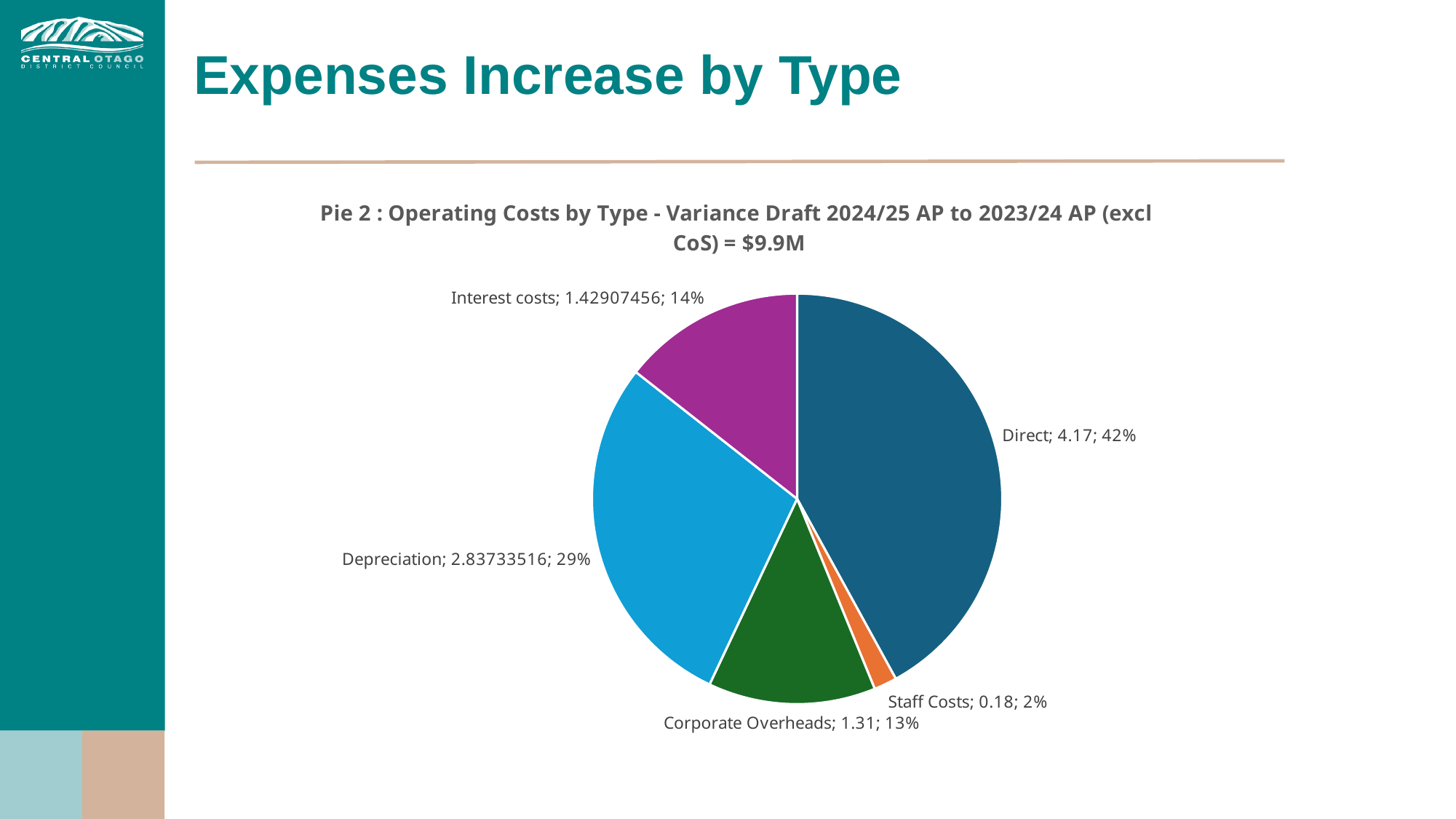
Which is larger, Corporate Overheads or Interest costs? Interest costs What is the difference between the values for Direct and Corporate Overheads? 2.86 How many categories are shown in the pie chart? 5 What is the value shown for Staff Costs? 0.18 What percentage share does Depreciation have? 29% What kind of chart is shown on the slide? Pie chart What total amount is stated in the chart title? $9.9M Which category has the largest slice? Direct Which category has the smallest slice? Staff Costs What is the value shown for Interest costs? 1.42907456 What percentage share does Corporate Overheads have? 13% What is the value shown for Direct? 4.17